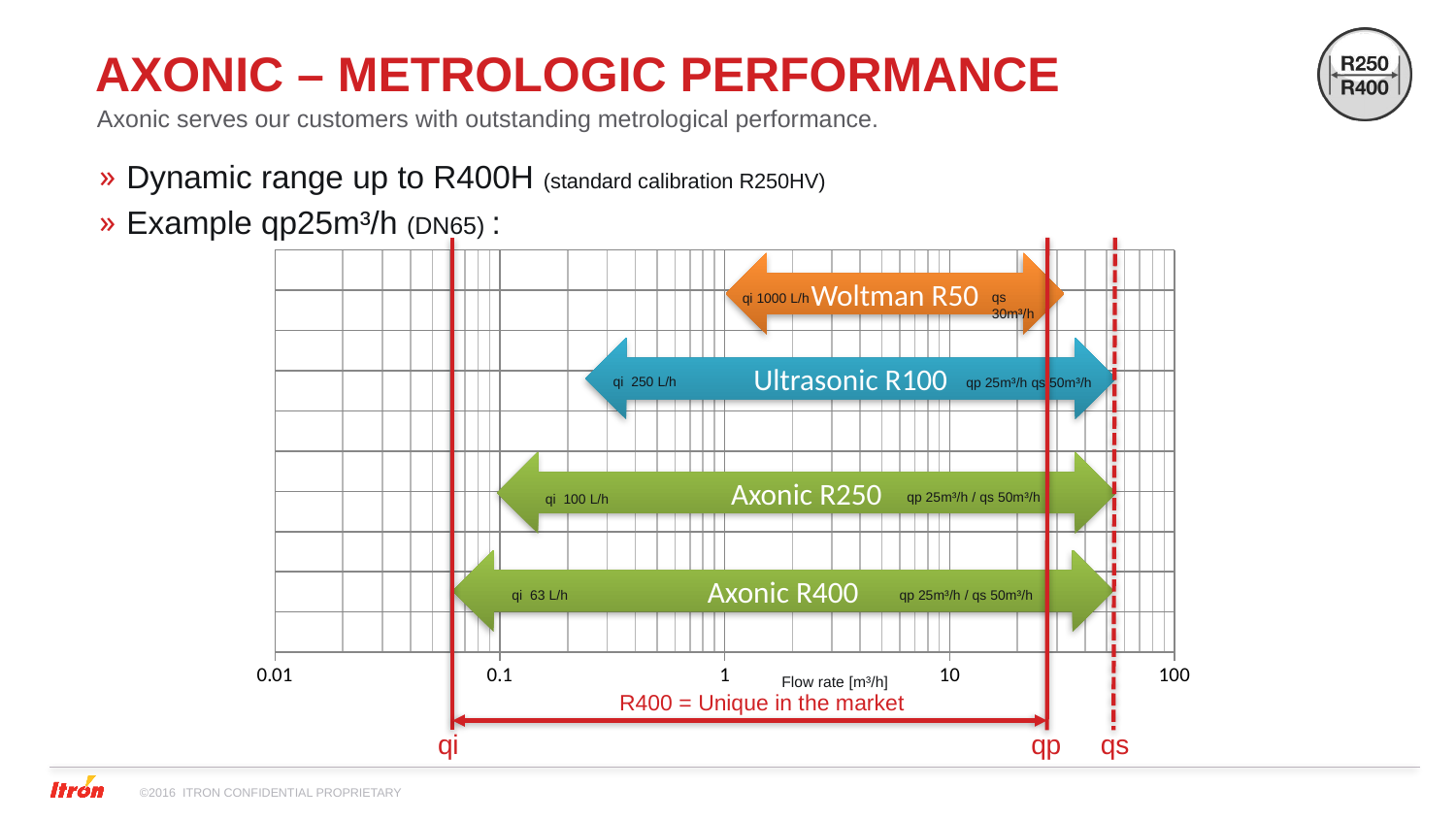
How many meter ranges (arrows) are plotted on the chart? 4 Which meter has the highest qi value on the chart? Woltman R50 What is the qp value shown for Axonic R250? 25m³/h What is the qi value shown for Woltman R50? 1000 L/h Which has a lower qi value, Axonic R250 or Ultrasonic R100? Axonic R250 Which meter has the lowest qi value on the chart? Axonic R400 What is the label of the x axis of the chart? Flow rate [m³/h] What is the qi value shown for Axonic R250? 100 L/h What is the qi value shown for Axonic R400? 63 L/h What is the qi value shown for Ultrasonic R100? 250 L/h What is the qs value shown for Woltman R50? 30m³/h What is the qs value shown for Axonic R400? 50m³/h